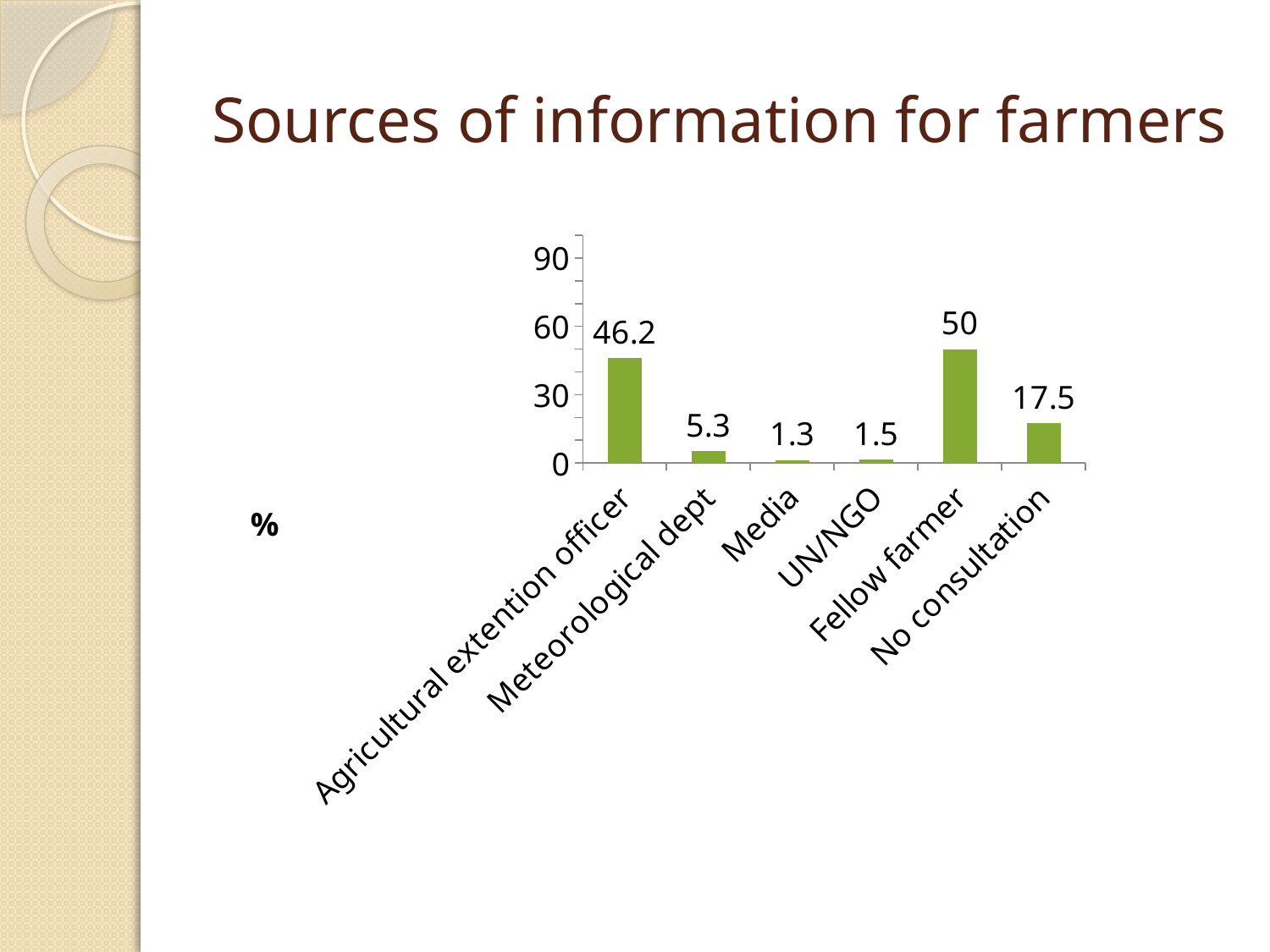
How many categories are shown on the x axis? 6 Is the value for No consultation greater or less than 30? less What is the value for Agricultural extention officer? 46.2 What is the value for Fellow farmer? 50 Which category has the lowest value? Media Which category has the highest value? Fellow farmer What is the title of the slide? Sources of information for farmers What is the difference between the values for Fellow farmer and Agricultural extention officer? 3.8 What is the value for No consultation? 17.5 What is the value for Meteorological dept? 5.3 Which is larger, the value for UN/NGO or the value for Meteorological dept? Meteorological dept What kind of chart is shown on the slide? bar chart